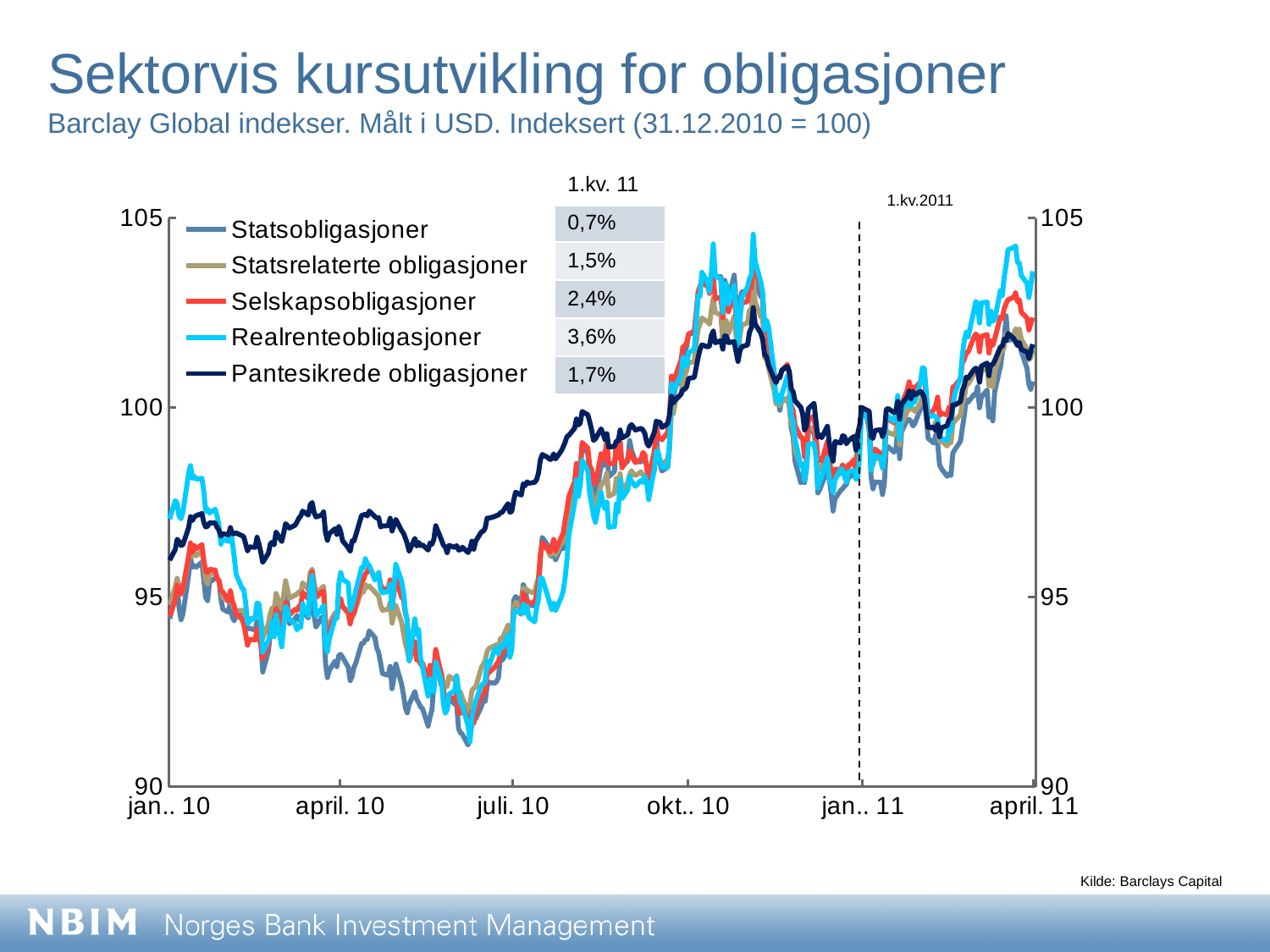
What is the difference between the 1.kv. 11 values for Realrenteobligasjoner and Statsobligasjoner? 2,9 percentage points What is the 1.kv. 11 value shown for Pantesikrede obligasjoner? 1,7% Does the Pantesikrede obligasjoner line rise or fall between jan.. 10 and okt.. 10? rise What is the title of the chart on the slide? Sektorvis kursutvikling for obligasjoner Which has the larger 1.kv. 11 value, Selskapsobligasjoner or Pantesikrede obligasjoner? Selskapsobligasjoner Which series has the highest 1.kv. 11 value? Realrenteobligasjoner What kind of chart is shown on the slide? Line chart What is the 1.kv. 11 value shown for Statsobligasjoner? 0,7% How many series does the legend list? 5 Is the value for Pantesikrede obligasjoner at jan.. 10 greater or less than 100? less Which series has the lowest 1.kv. 11 value? Statsobligasjoner What is the 1.kv. 11 value shown for Realrenteobligasjoner? 3,6%